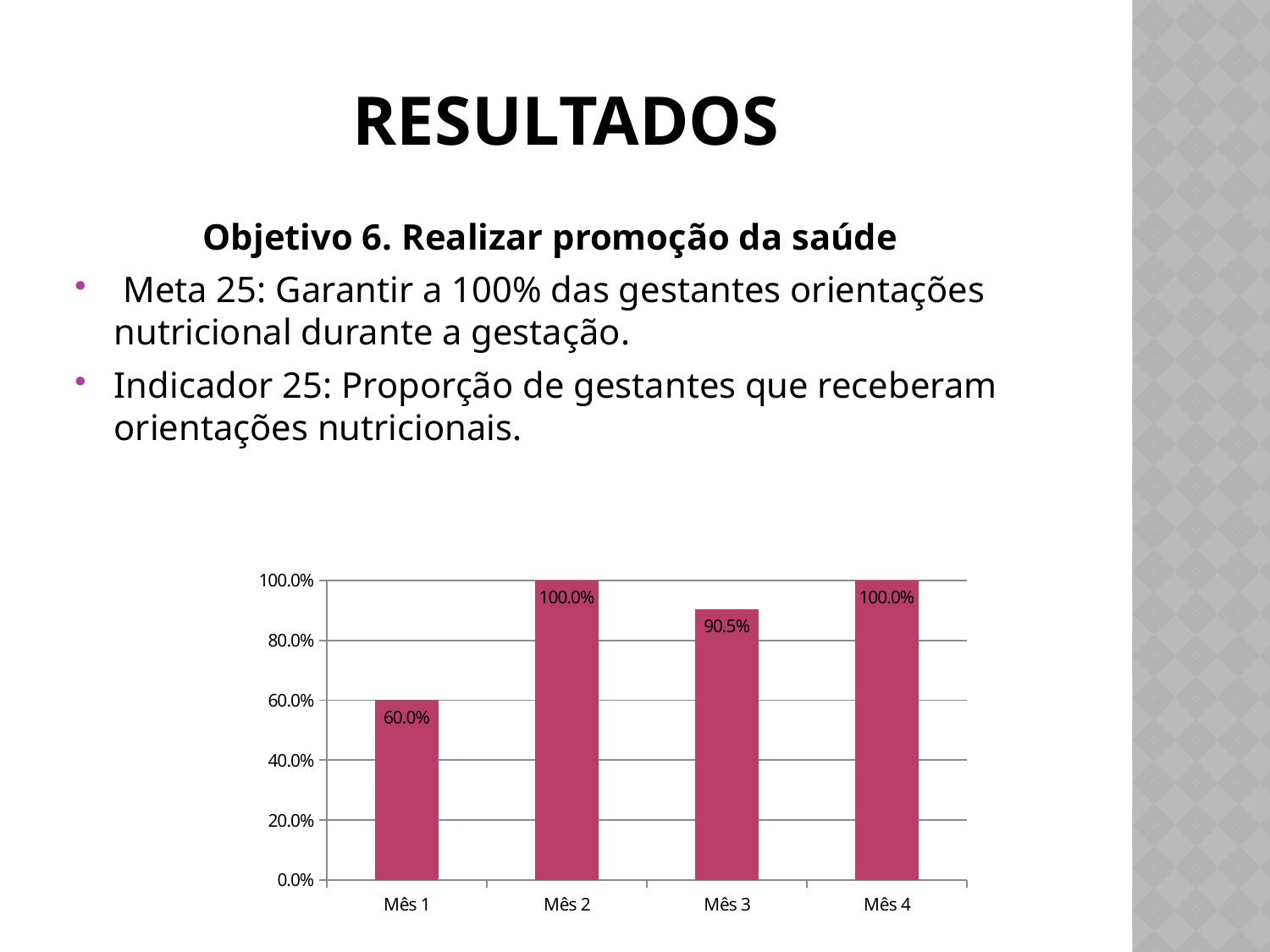
What kind of chart is shown on the slide? bar chart What is the value for Mês 2? 100.0% How many months are shown on the x axis? 4 What is the difference between the values for Mês 2 and Mês 3? 9.5% How many months reach 100.0%? 2 What colour are the bars in the chart? magenta/pink What is the value for Mês 1? 60.0% What is the difference between the values for Mês 3 and Mês 1? 30.5% Is the value for Mês 3 greater or less than 80.0%? greater Which month has the lowest value? Mês 1 What is the value for Mês 3? 90.5% Which is larger, the value for Mês 1 or the value for Mês 3? Mês 3